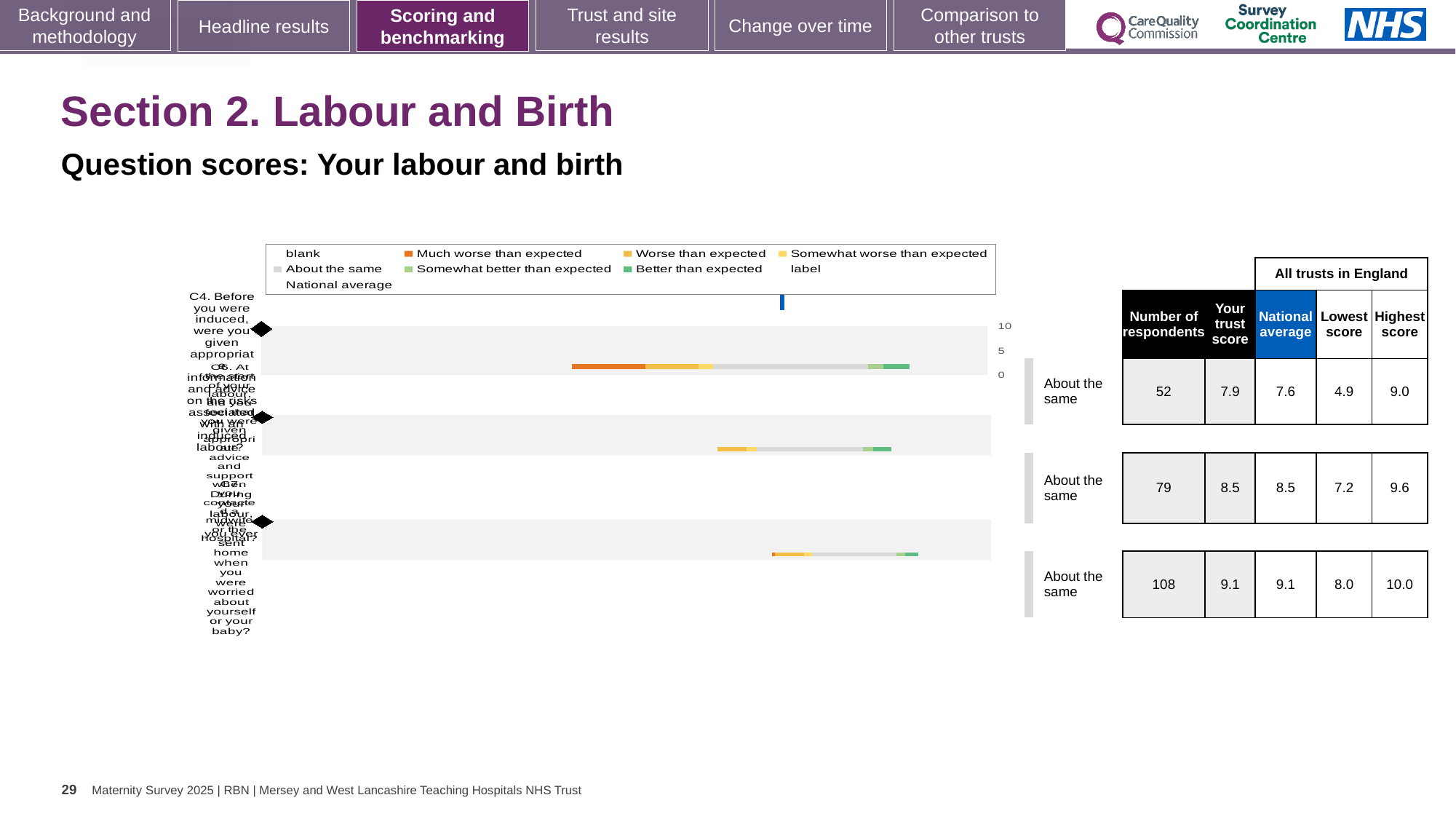
How many question rows (bars) does the chart show? 3 In the table, what is the 'Your trust score' value for the second (middle) row? 8.5 For the first (top) row, which is larger: the trust score or the national average? the trust score (7.9) Do the 'Your trust score' values rise or fall going from the top row to the bottom row of the table? rise In the table, what is the national average for the third (bottom) row? 9.1 Which row of the table has the largest number of respondents? the third (bottom) row, 108 Which row of the table has the lowest 'Lowest score' value? the first (top) row, 4.9 What colour does the legend use for 'Much worse than expected'? orange For the third (bottom) row, what is the difference between the highest score and the lowest score? 2.0 In the table next to the chart, what is the number of respondents for the first (top) row? 52 What kind of chart is shown on the slide? bar chart In the table, what is the highest score for the first (top) row? 9.0